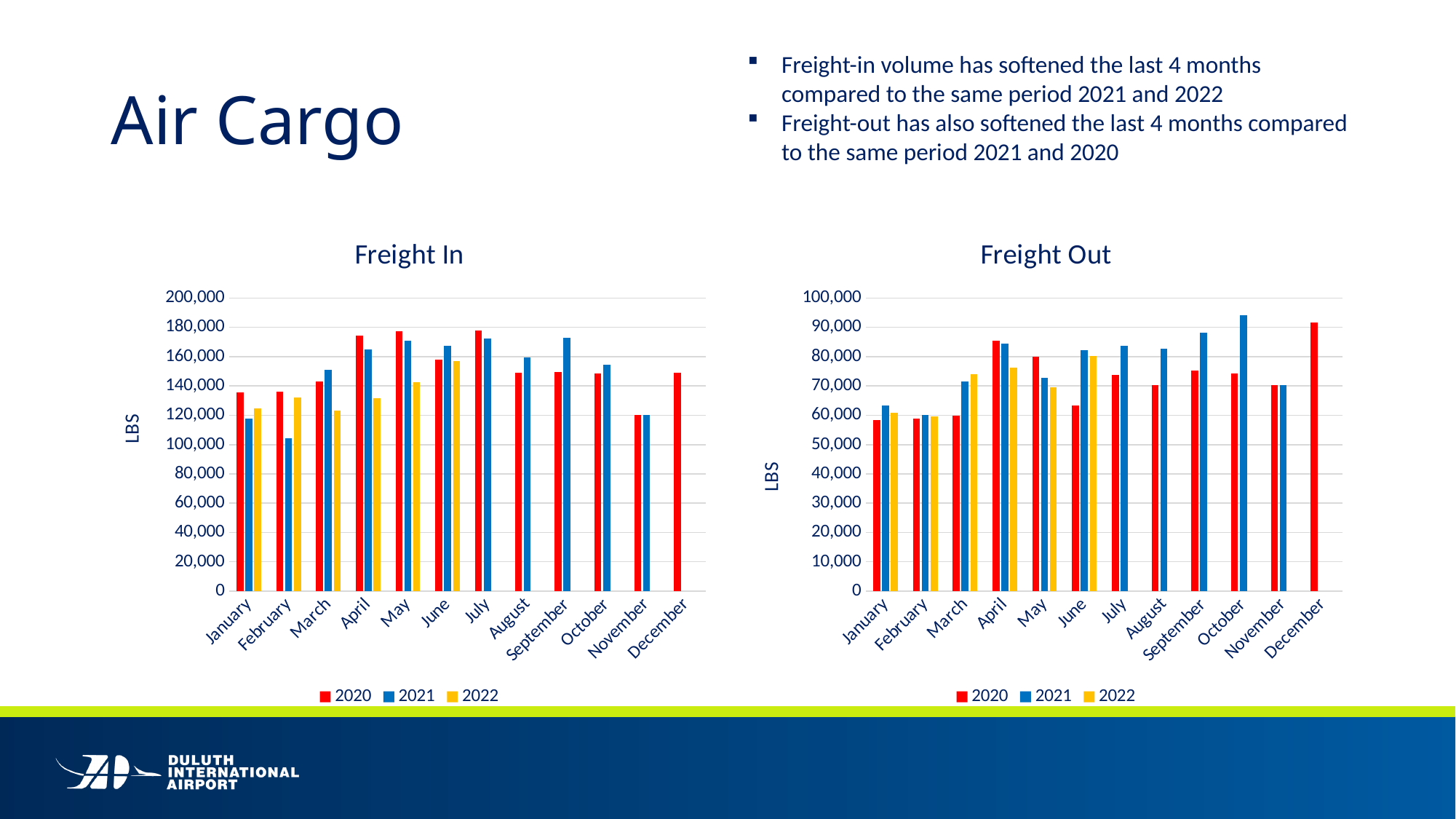
In the Freight Out chart, is the 2020 value for December greater or less than 80,000? greater In the Freight Out chart, is the 2021 value for October greater or less than 90,000? greater In the Freight Out chart, which is larger in June, the 2020 value or the 2021 value? 2021 In the Freight In chart, is the 2020 value for July greater or less than 160,000? greater In the Freight In chart, which month has the lowest 2021 value? February What is the y-axis label of the Freight Out chart? LBS In the Freight In chart, which is larger in February, the 2020 value or the 2021 value? 2020 How many series does the legend of the Freight In chart list? 3 In the Freight Out chart, which month has the highest 2021 value? October How many months are shown on the x axis of the Freight Out chart? 12 What kind of chart is the Freight In chart? bar chart